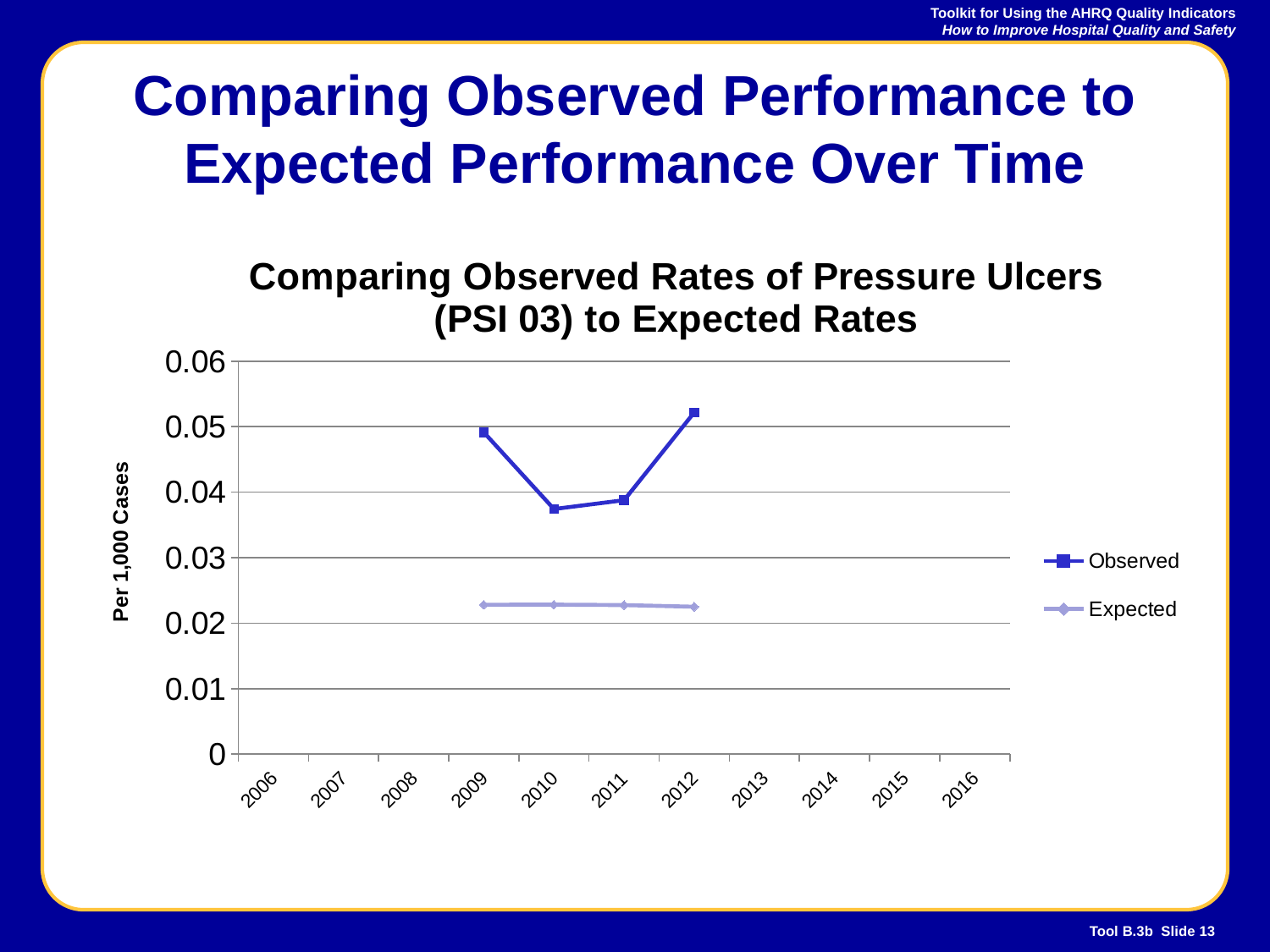
Is the Expected value for 2009 greater or less than 0.02? greater Is the Observed value for 2010 greater or less than 0.04? less Does the Observed rate rise or fall from 2011 to 2012? rise For how many years are data points plotted for the Observed series? 4 What is the label on the vertical axis? Per 1,000 Cases In which year is the Observed rate highest? 2012 Is the Expected value for 2011 greater or less than 0.03? less What are the two series named in the legend? Observed and Expected How many series does the legend list? 2 What kind of chart is shown on the slide? line chart In 2012, which is larger, the Observed rate or the Expected rate? Observed